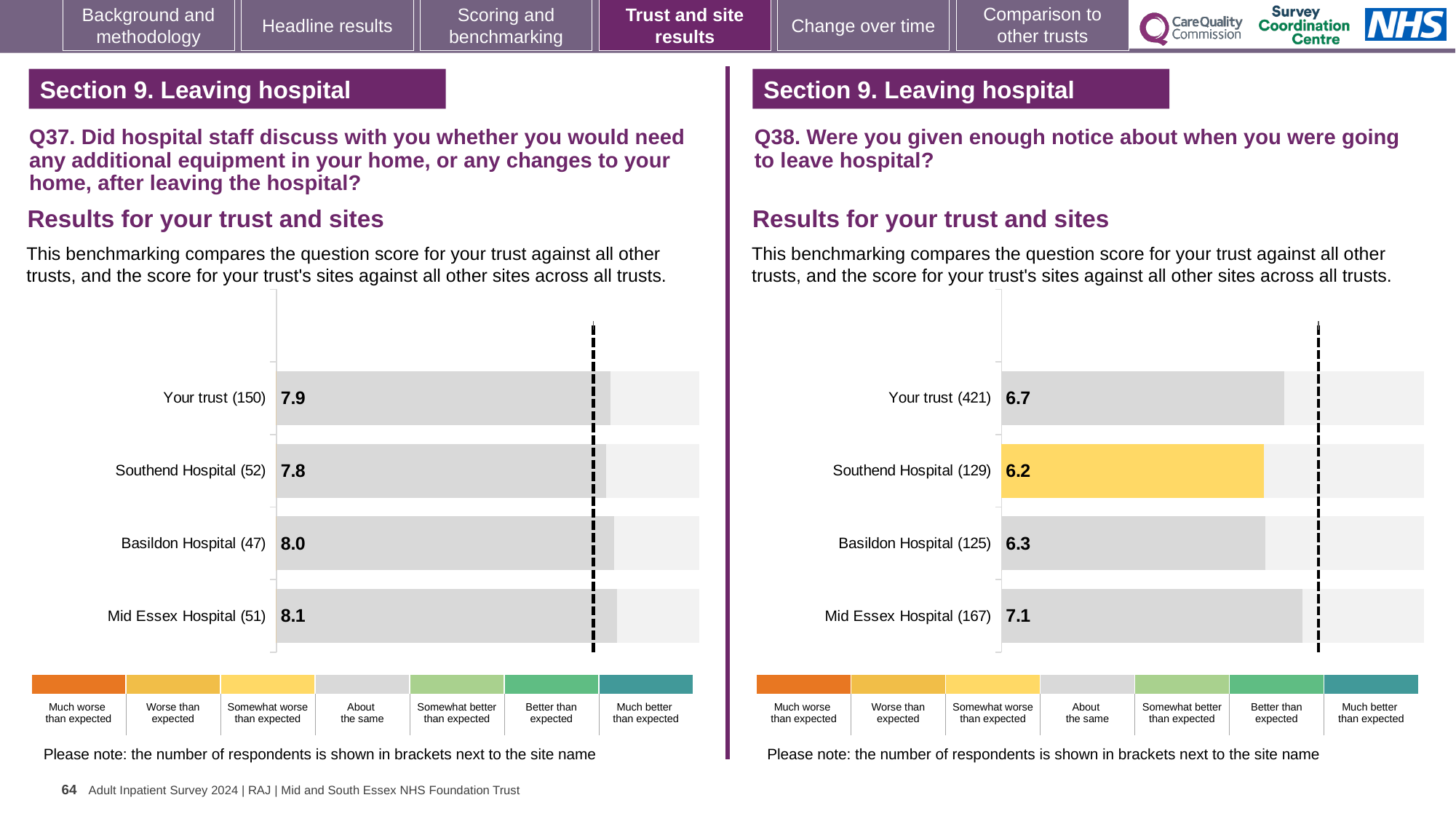
In the Q38 chart on the right, which is larger, the score for Basildon Hospital or the score for Mid Essex Hospital? Mid Essex Hospital In the Q37 chart on the left, which site or trust has the lowest score? Southend Hospital In the Q38 chart on the right, what is the difference between the scores for Your trust and Southend Hospital? 0.5 In the Q37 chart on the left, what is the score for Basildon Hospital? 8.0 In the Q37 chart on the left, what is the score for Your trust? 7.9 In the Q38 chart on the right, which site or trust has the lowest score? Southend Hospital In the Q37 chart on the left, which site or trust has the highest score? Mid Essex Hospital In the Q38 chart on the right, which benchmark category does the colour of the Southend Hospital bar indicate? Somewhat worse than expected In the Q37 chart on the left, what is the difference between the scores for Mid Essex Hospital and Southend Hospital? 0.3 How many bars are plotted in the Q37 chart on the left? 4 In the Q38 chart on the right, what is the score for Mid Essex Hospital? 7.1 In the Q38 chart on the right, what is the score for Your trust? 6.7